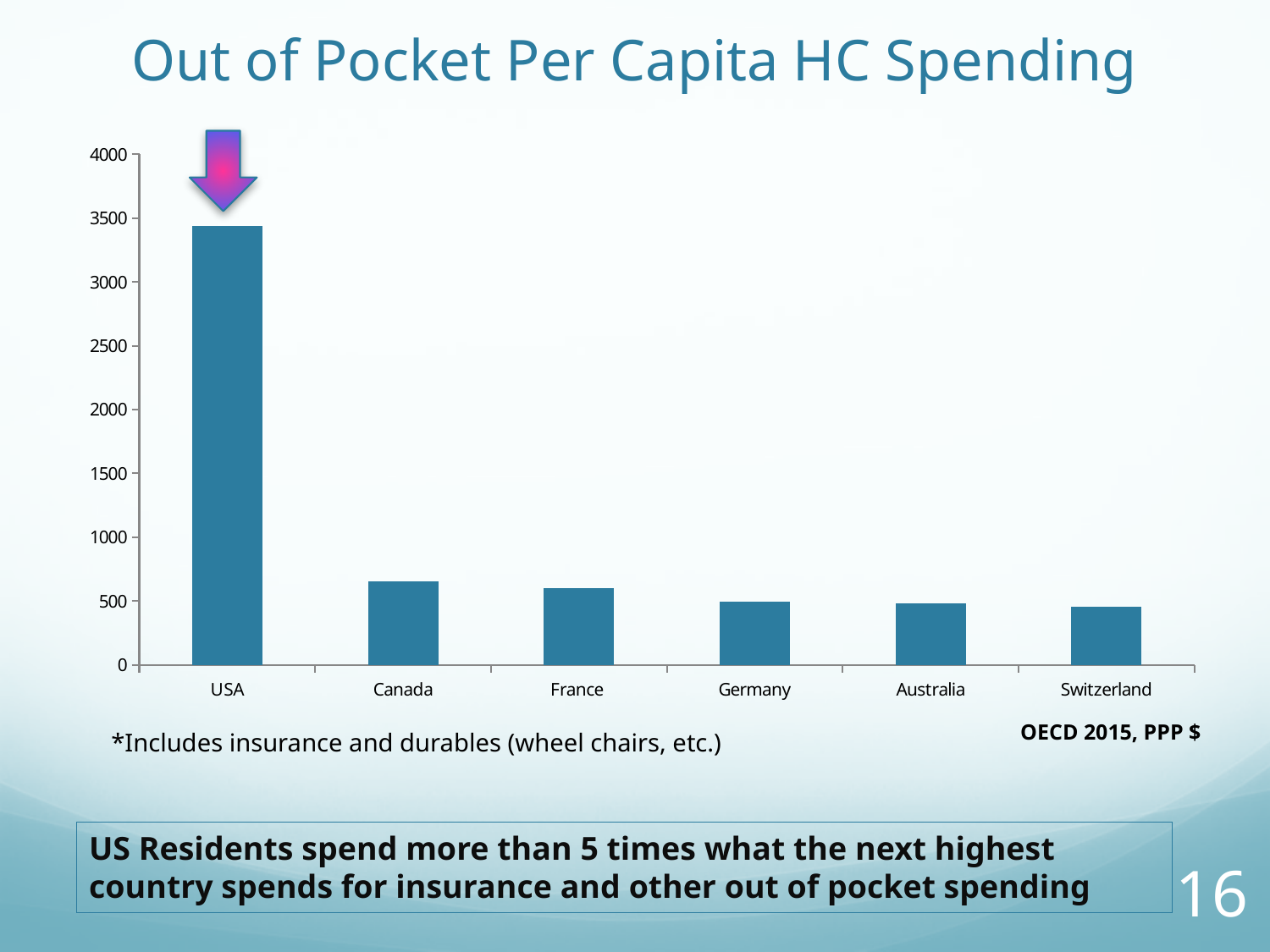
Which is larger, the value for Canada or the value for Germany? Canada Is the value for Canada greater or less than 500? greater Is the value for Germany greater or less than 1000? less Is the value for France greater or less than 1000? less Which country has the highest out of pocket per capita HC spending in the chart? USA Do the values rise or fall moving from left to right along the x axis? fall What is the title of the chart on the slide? Out of Pocket Per Capita HC Spending What kind of chart is shown on the slide? bar chart Which is larger, the value for USA or the value for Canada? USA How many countries are shown on the x axis of the chart? 6